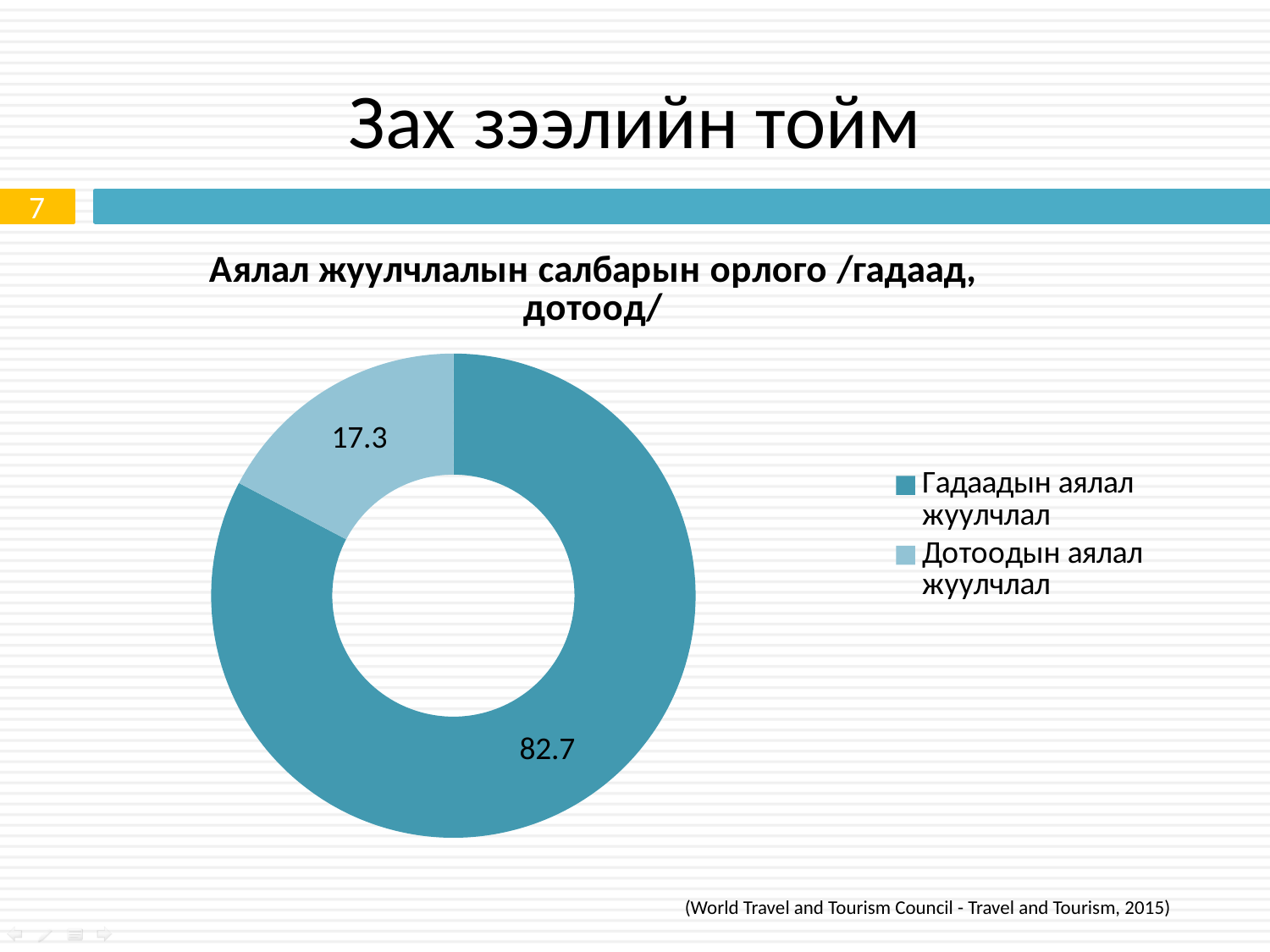
What is the source cited below the chart? World Travel and Tourism Council - Travel and Tourism, 2015 What is the value for Дотоодын аялал жуулчлал? 17.3 What is the difference between the values for Гадаадын аялал жуулчлал and Дотоодын аялал жуулчлал? 65.4 What is the title of the chart? Аялал жуулчлалын салбарын орлого /гадаад, дотоод/ What is the total of the two values shown on the chart? 100 How many entries does the legend list? 2 What is the value for Гадаадын аялал жуулчлал? 82.7 What kind of chart is shown on the slide? Doughnut (pie) chart Which category has the largest share of the chart? Гадаадын аялал жуулчлал Which is larger, the value for Гадаадын аялал жуулчлал or Дотоодын аялал жуулчлал? Гадаадын аялал жуулчлал Which category has the smallest share of the chart? Дотоодын аялал жуулчлал How many categories does the chart show? 2